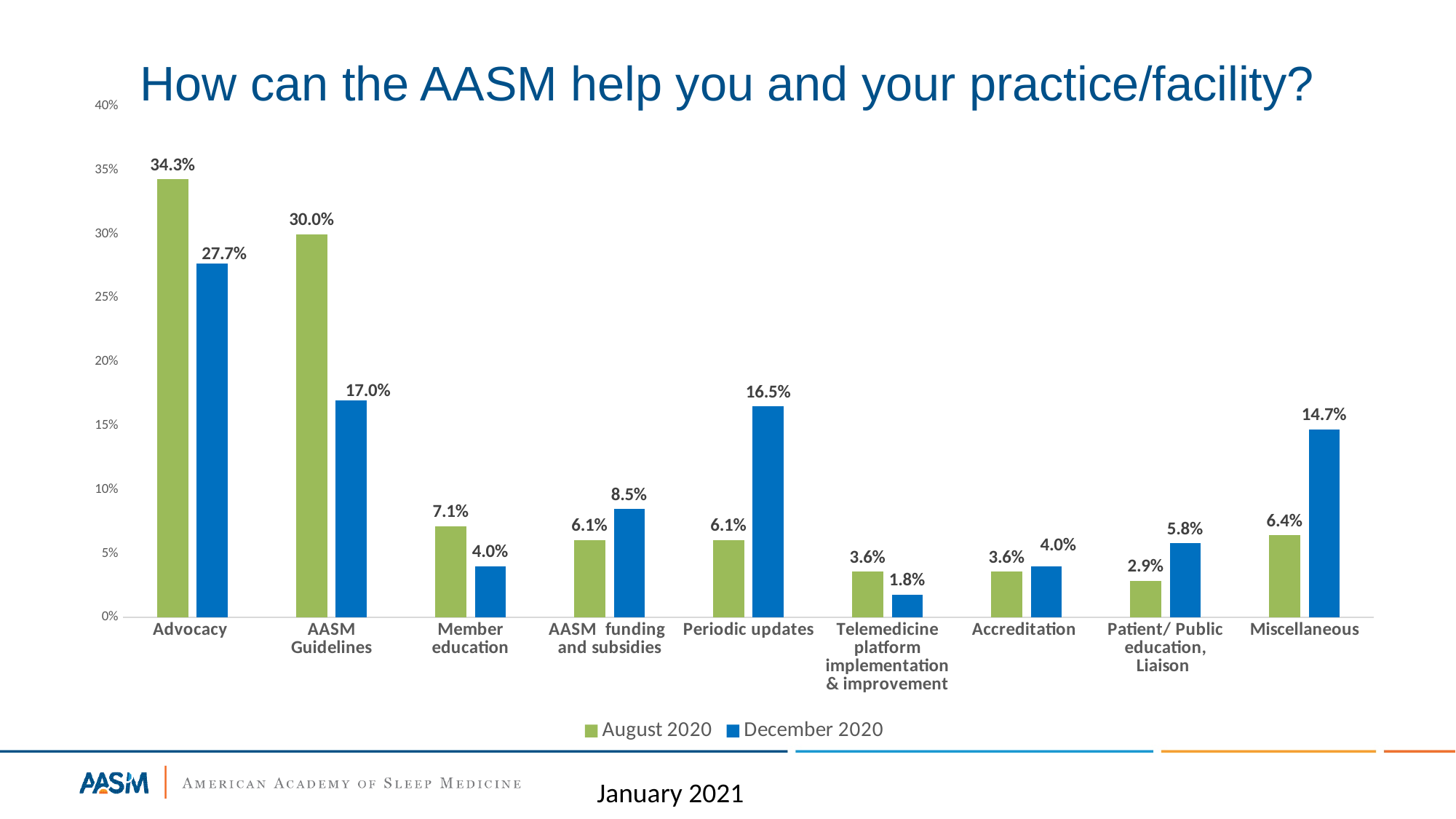
How many series does the legend list? 2 What is the difference between the August 2020 and December 2020 values for AASM Guidelines? 13.0% How many categories are shown on the x axis? 9 What is the December 2020 value for Miscellaneous? 14.7% Which is larger for Member education: the August 2020 value or the December 2020 value? August 2020 What is the August 2020 value for Advocacy? 34.3% Which category has the highest December 2020 value? Advocacy Which category has the lowest December 2020 value? Telemedicine platform implementation & improvement Which colour represents December 2020 in the chart? Blue What is the August 2020 value for Patient/ Public education, Liaison? 2.9% What kind of chart is shown on the slide? Bar chart What is the December 2020 value for Periodic updates? 16.5%